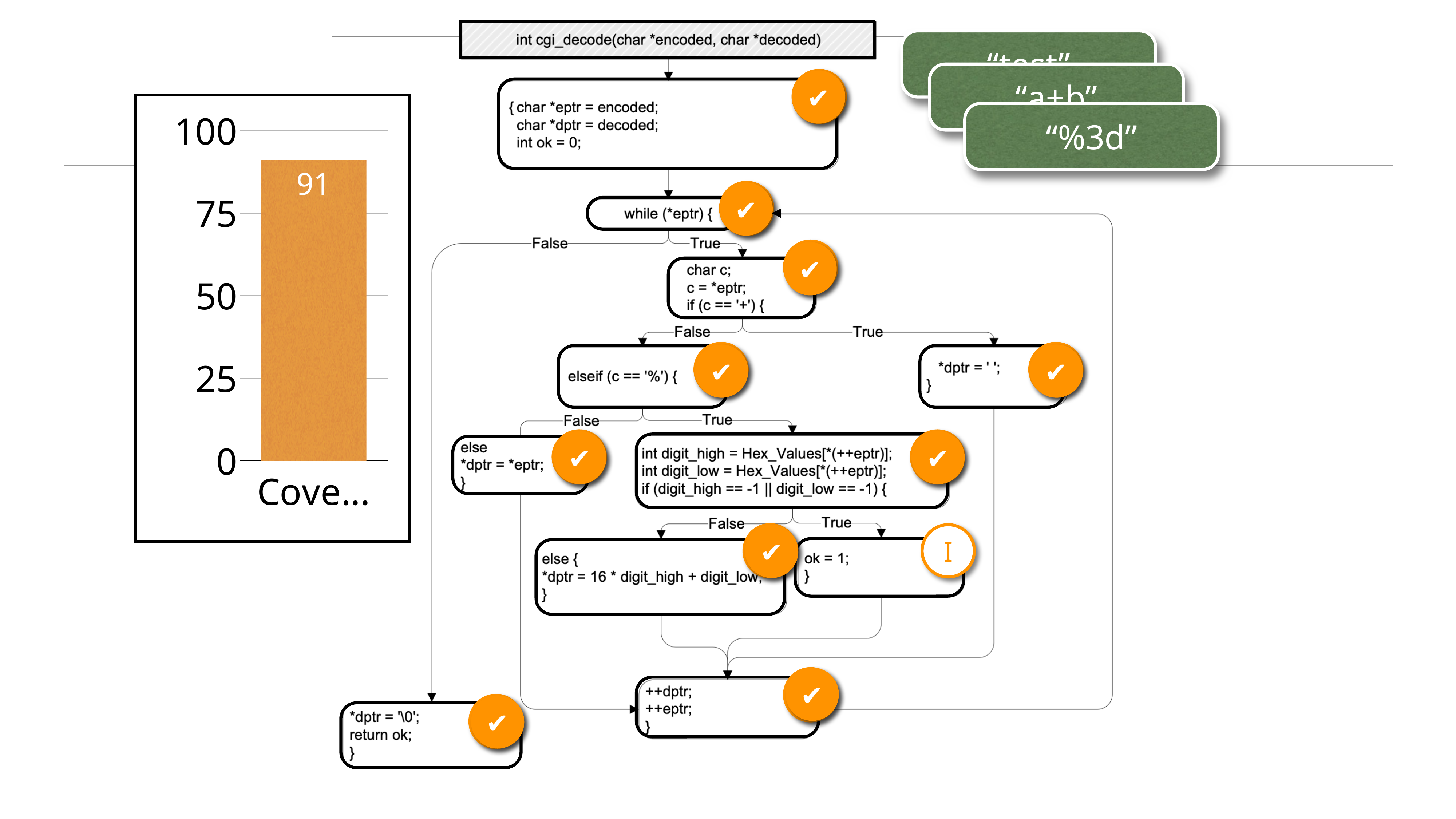
Is the value of the bar in the chart greater or less than 75? greater How many bars does the chart contain? 1 Is the value of the bar in the chart greater or less than 50? greater What colour is the bar in the chart? orange What is the highest tick value shown on the chart's vertical axis? 100 What value is shown on the bar in the chart? 91 Is the value of the bar in the chart greater or less than 100? less What kind of chart is shown on the left of the slide? bar chart